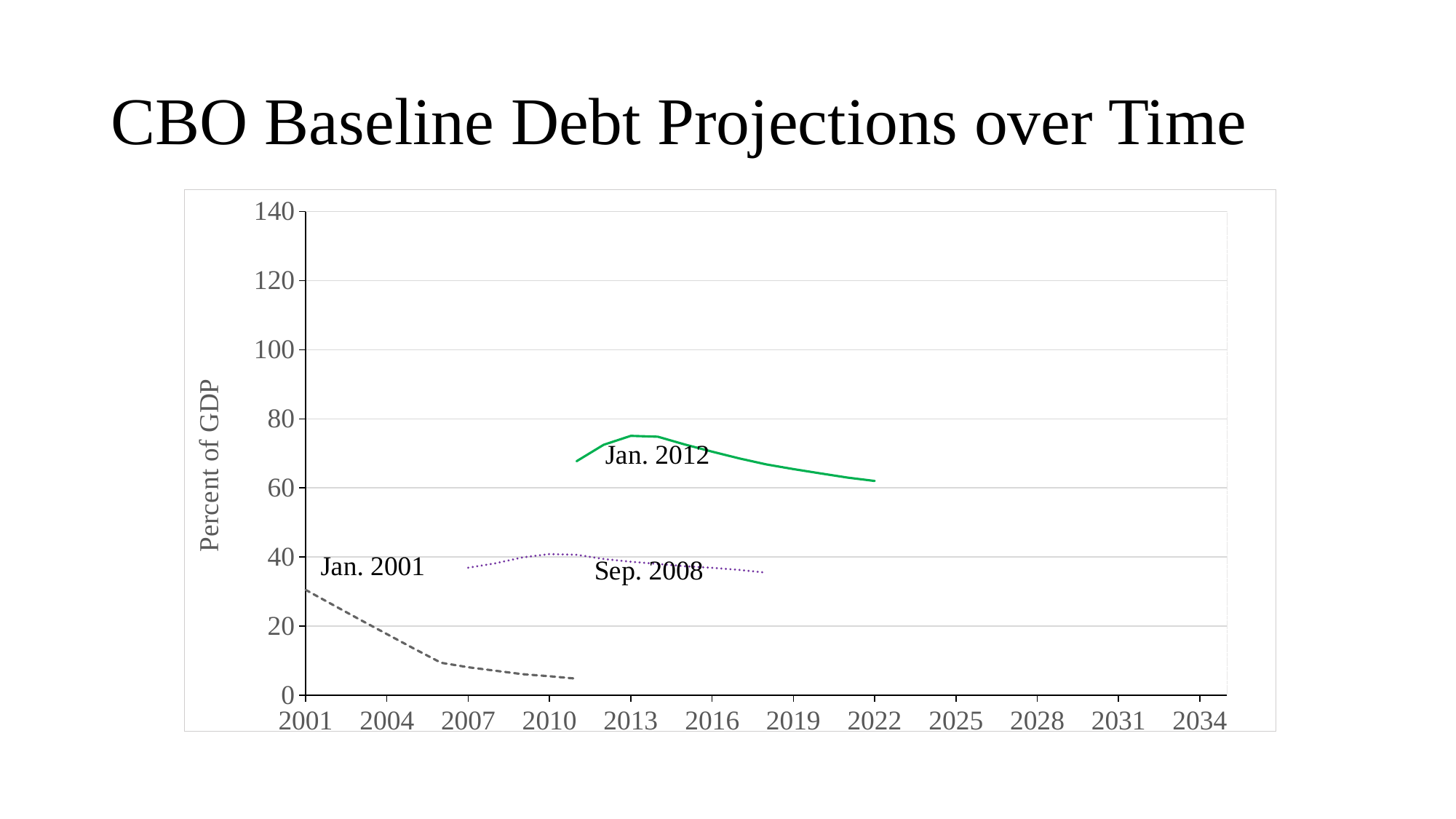
After its peak around 2013, does the Jan. 2012 projection rise or fall? fall Does the Jan. 2001 projection rise or fall over time? fall Around 2013, which is higher: the Jan. 2012 projection or the Sep. 2008 projection? Jan. 2012 Which projection series has the lowest values on the chart? Jan. 2001 How many projection series are plotted on the chart? 3 What is the label on the vertical axis? Percent of GDP Is the Jan. 2001 projection's starting value in 2001 greater or less than 40? less What kind of chart is shown on the slide? line chart Is the Jan. 2001 projection's value in 2010 greater or less than 20? less What is the title of the chart on the slide? CBO Baseline Debt Projections over Time Is the peak value of the Jan. 2012 projection greater or less than 60? greater Which projection series reaches the highest value on the chart? Jan. 2012